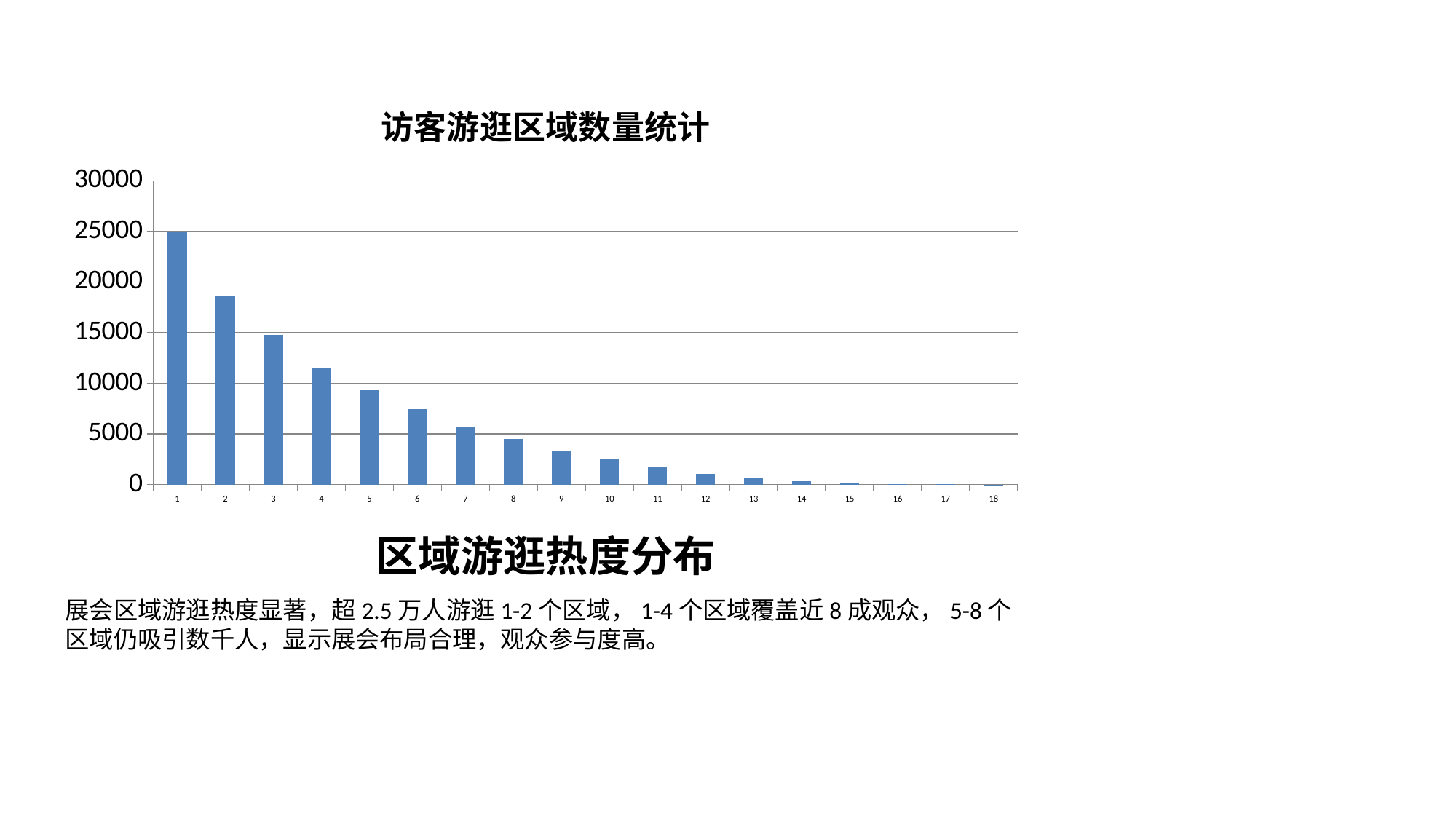
Is the value for category 4 greater or less than 10000? greater Which category has the highest value in the chart? 1 Which has the larger value, category 9 or category 5? 5 Is the value for category 2 greater or less than 15000? greater How many categories are shown on the x axis of the chart? 18 Is the value for category 5 greater or less than 10000? less Which has the larger value, category 2 or category 3? 2 What kind of chart is shown on the slide? bar chart Do the values rise or fall as you move from category 1 to category 18 along the x axis? fall What is the title of the chart? 访客游逛区域数量统计